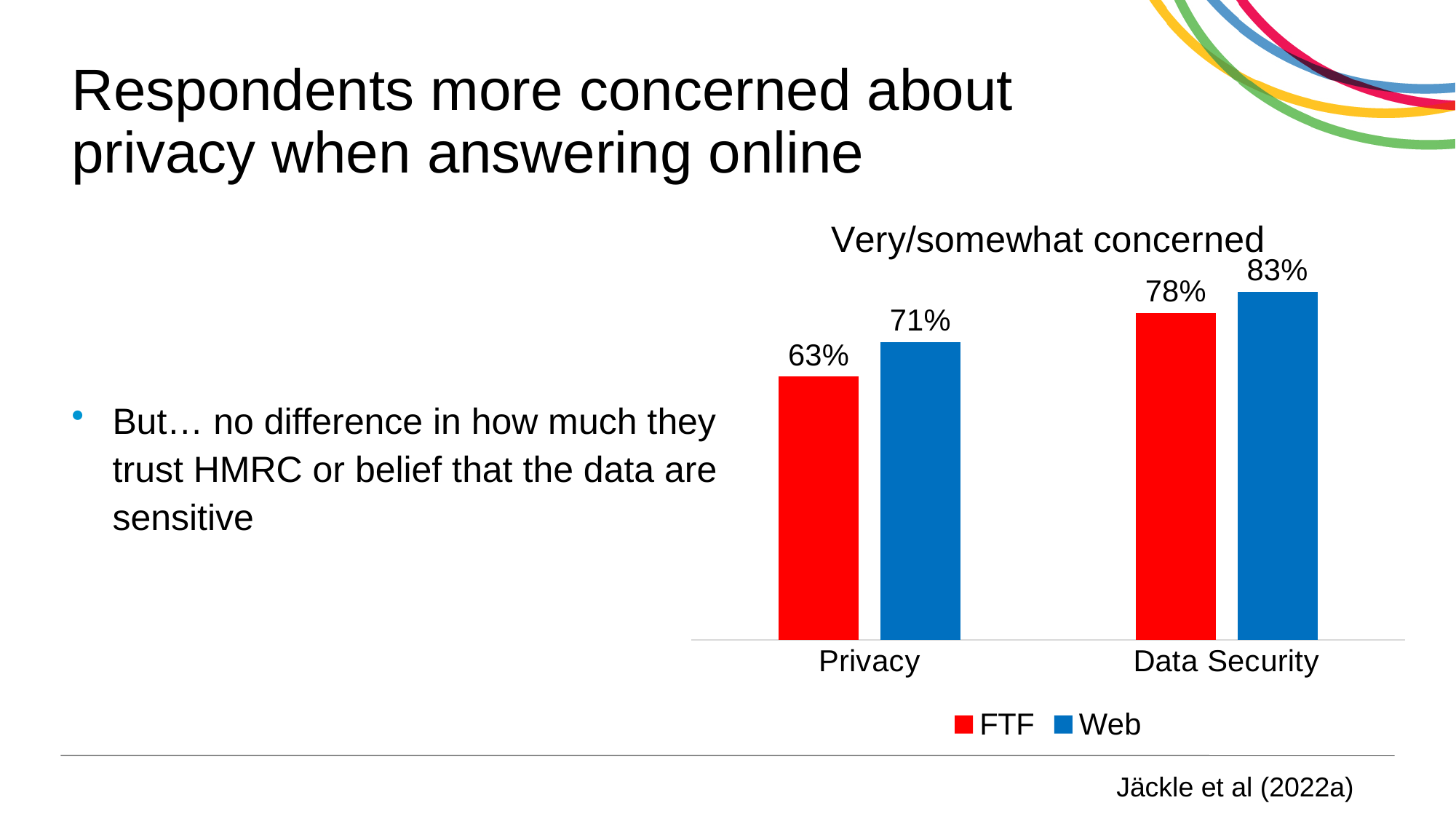
What is the difference between the Web and FTF values for Data Security? 5% What is the Web value for Privacy? 71% How many series does the legend list? 2 Which category has the lowest FTF value? Privacy Which category has the highest Web value? Data Security What is the difference between the Web and FTF values for Privacy? 8% What is the title of the chart? Very/somewhat concerned How many categories are shown on the x axis? 2 For Data Security, which is larger, the FTF value or the Web value? Web What is the FTF value for Data Security? 78% What is the FTF value for Privacy? 63% What is the Web value for Data Security? 83%